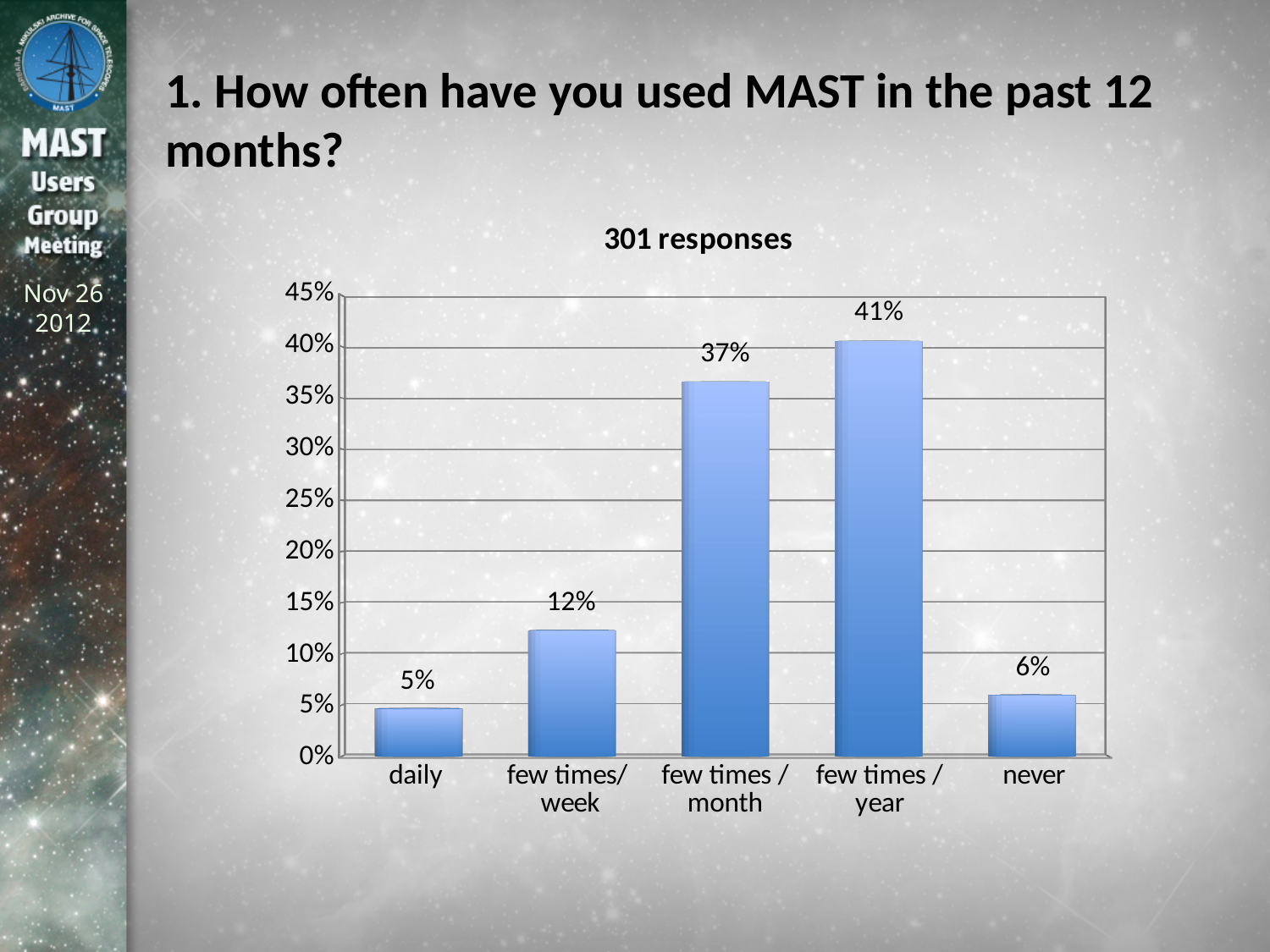
What is the value for 'few times / month'? 37% Which category has the lowest value? daily Which category has the highest value? few times / year What percentage of respondents said they never used MAST in the past 12 months? 6% What kind of chart is shown on the slide? bar chart How many categories are shown on the x axis? 5 What is the difference between the 'few times / year' and 'few times / month' values? 4% What is the difference between the 'few times/ week' value and the 'daily' value? 7% What percentage of respondents said they used MAST daily? 5% Which is larger, the value for 'few times/ week' or the value for 'never'? few times/ week Is the value for 'few times / month' greater or less than 35%? greater What is the title of the chart? 301 responses